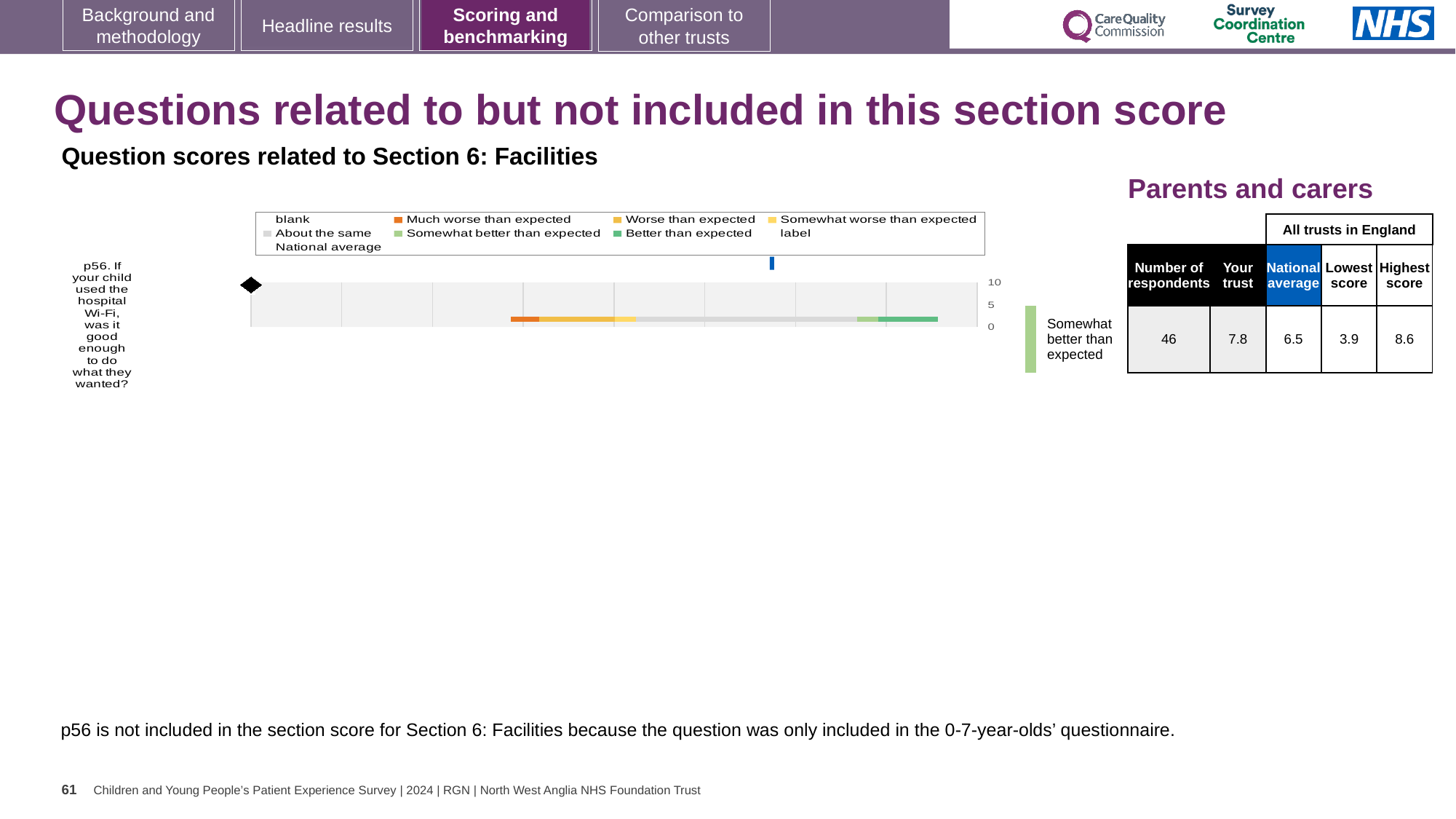
How many survey questions are plotted on the chart? 1 How many respondents answered p56? 46 What kind of chart is used to show the expected-range bands for question p56? bar chart Which question is plotted on the chart? p56. If your child used the hospital Wi-Fi, was it good enough to do what they wanted? What is the lowest score among all trusts in England for p56? 3.9 What is the highest value shown on the chart's axis? 10 What is the 'Your trust' score for p56 shown in the table next to the chart? 7.8 What is the difference between the trust's score and the national average for p56? 1.3 What is the national average score for p56 shown in the table next to the chart? 6.5 Which is larger for p56, the trust's score or the national average? Your trust What is the highest score among all trusts in England for p56? 8.6 Which benchmark category is the trust's p56 result placed in? Somewhat better than expected